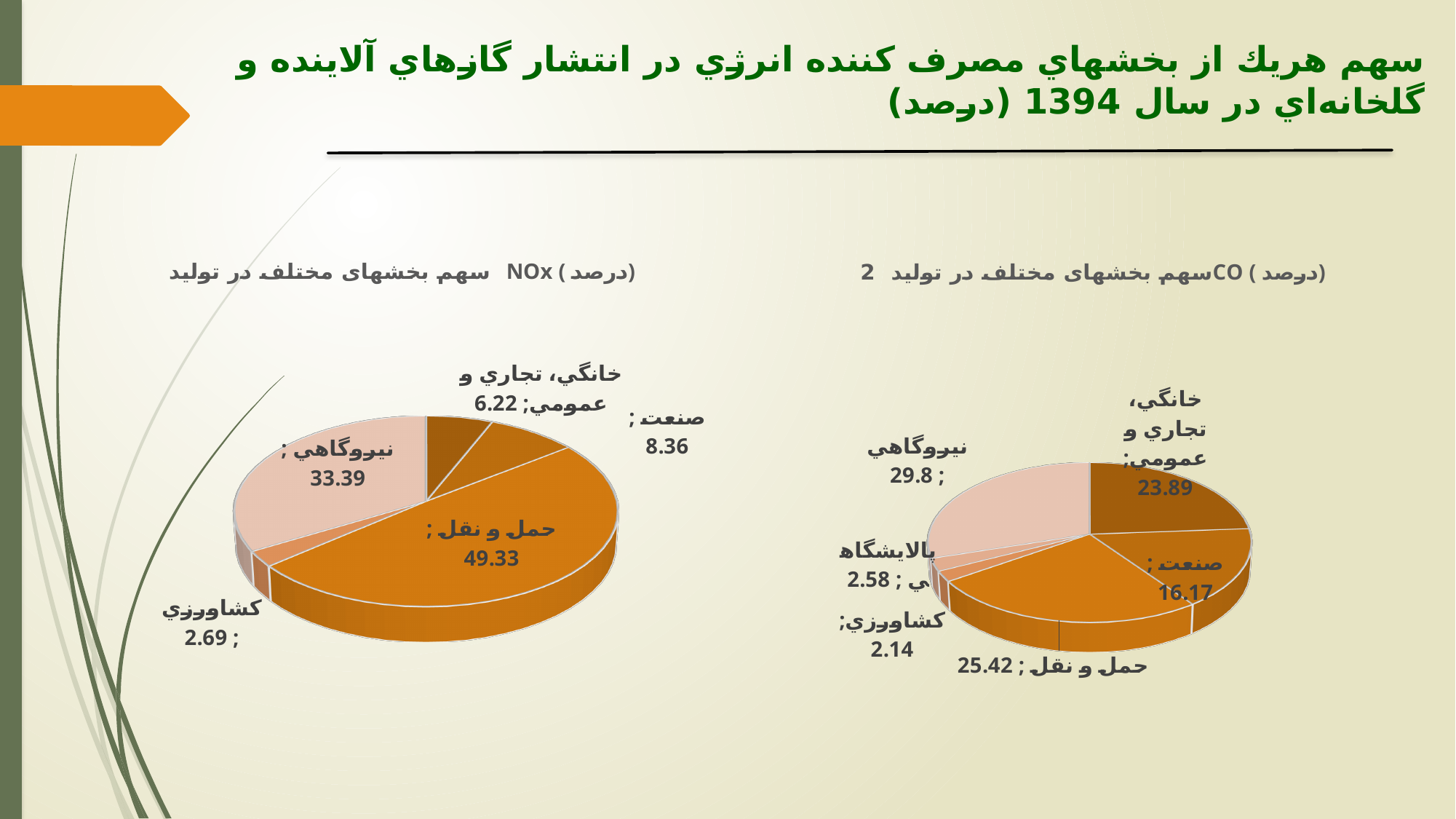
In the right-hand chart (CO2 share), what is the value for صنعت? 16.17 How many slices does the left-hand chart (NOx share) have? 5 In the left-hand chart (NOx share), what is the value for كشاورزي? 2.69 In the left-hand chart (NOx share), what is the difference between حمل و نقل and نيروگاهي? 15.94 In the left-hand chart (NOx share), what is the value for حمل و نقل? 49.33 In the right-hand chart (CO2 share), what is the value for نيروگاهي? 29.8 In the right-hand chart (CO2 share), which is larger: حمل و نقل or خانگي، تجاري و عمومي? حمل و نقل In the left-hand chart (NOx share), which sector has the largest slice? حمل و نقل In the right-hand chart (CO2 share), which sector has the smallest slice? كشاورزي What type of chart is used on this slide? Pie chart In the right-hand chart (CO2 share), which sector has the largest slice? نيروگاهي How many slices does the right-hand chart (CO2 share) have? 6